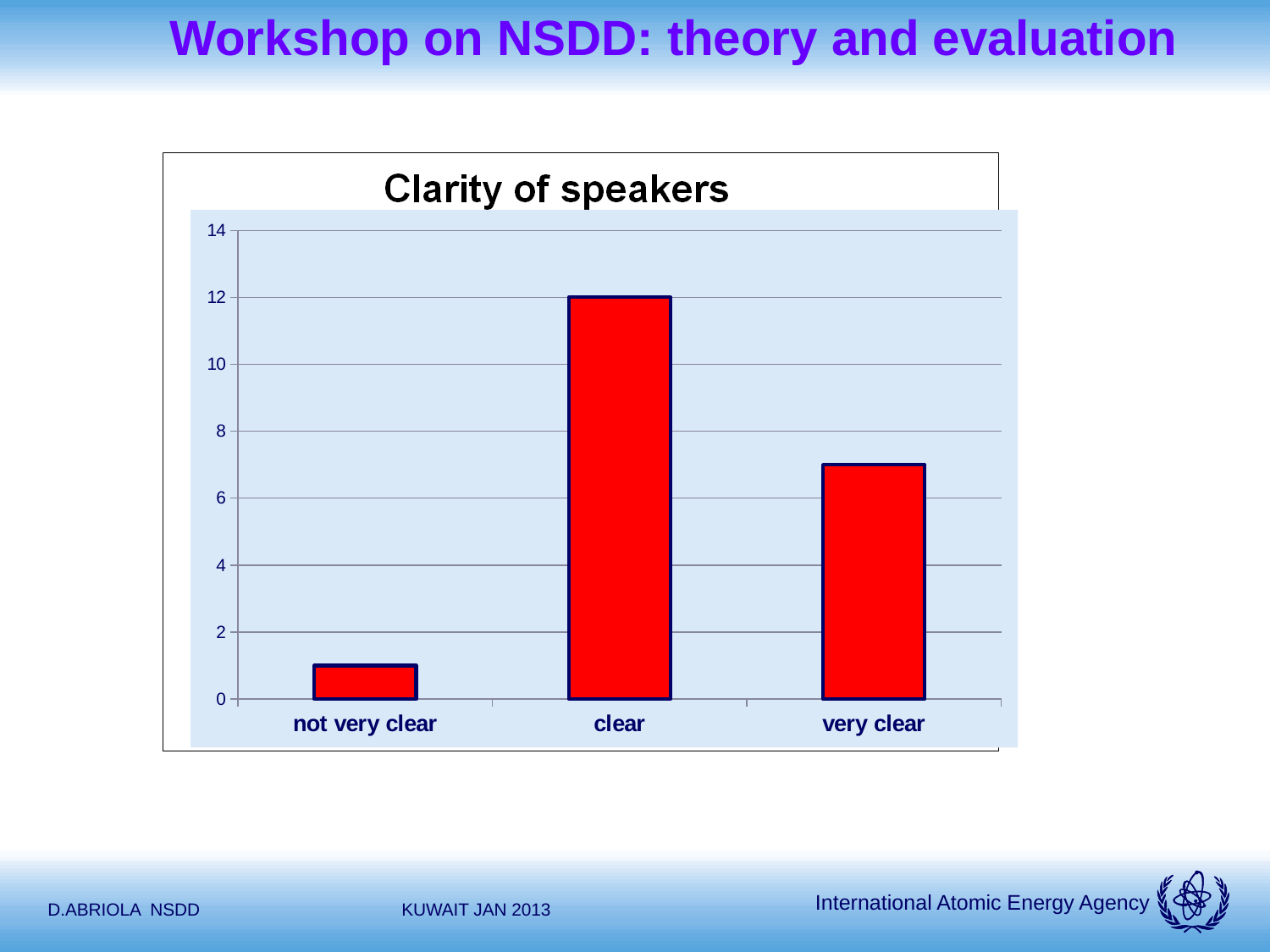
Does the value fall or rise from "clear" to "very clear"? fall What kind of chart is shown on the slide? bar chart Which category has the lowest bar in the Clarity of speakers chart? not very clear What is the value for "clear" in the Clarity of speakers chart? 12 Is the value for "very clear" greater or less than 6? greater Is the value for "very clear" greater or less than 8? less Which is larger in the Clarity of speakers chart, the value for "very clear" or the value for "not very clear"? very clear Which is larger in the Clarity of speakers chart, the value for "clear" or the value for "very clear"? clear Which category has the highest bar in the Clarity of speakers chart? clear How many categories are shown on the x axis of the Clarity of speakers chart? 3 What is the title of the chart on the slide? Clarity of speakers Is the value for "not very clear" greater or less than 2? less